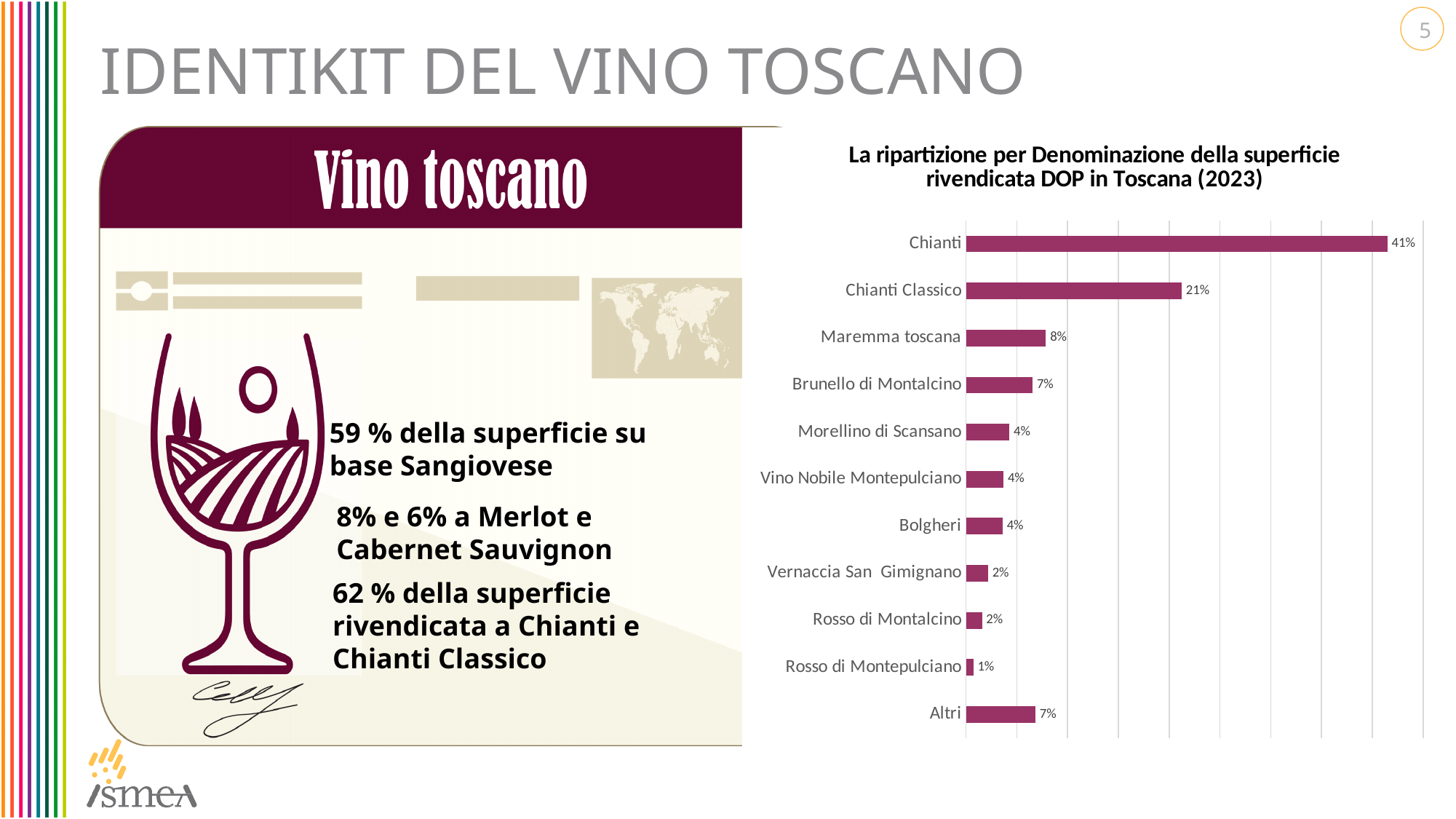
What is the title of the chart? La ripartizione per Denominazione della superficie rivendicata DOP in Toscana (2023) Which is larger, the value for Maremma toscana or the value for Brunello di Montalcino? Maremma toscana What is the combined value of Chianti and Chianti Classico? 62% What kind of chart is shown on the slide? Bar chart What is the value for Brunello di Montalcino? 7% Which denomination has the highest share in the chart? Chianti What is the difference between the values for Chianti and Chianti Classico? 20% What is the value for Chianti Classico? 21% What is the value for Rosso di Montepulciano? 1% How many categories are shown in the chart? 11 Which denomination has the lowest share in the chart? Rosso di Montepulciano What is the value for Chianti in the chart? 41%